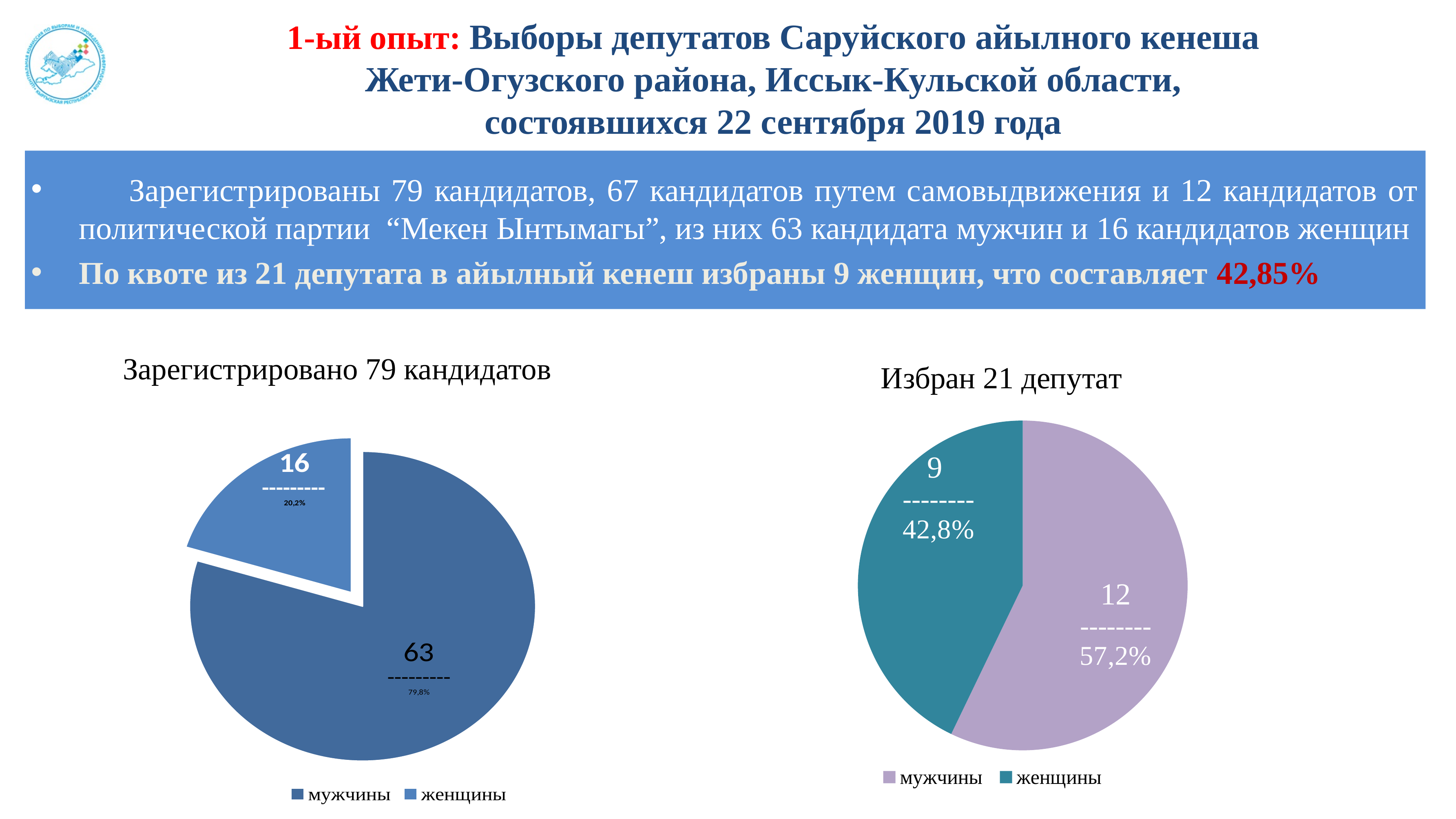
What kind of chart is the left chart 'Зарегистрировано 79 кандидатов'? pie chart In the right chart 'Избран 21 депутат', which category is the largest? мужчины In the left chart 'Зарегистрировано 79 кандидатов', what is the value for женщины? 16 In the left chart 'Зарегистрировано 79 кандидатов', what is the difference between мужчины and женщины? 47 In the right chart 'Избран 21 депутат', what share of the pie is женщины? 42,8% In the left chart 'Зарегистрировано 79 кандидатов', what is the value for мужчины? 63 In the left chart 'Зарегистрировано 79 кандидатов', what share of the pie is мужчины? 79,8% In the right chart 'Избран 21 депутат', what is the value for мужчины? 12 In the right chart 'Избран 21 депутат', what is the value for женщины? 9 How many entries does the legend of the right chart 'Избран 21 депутат' list? 2 In the right chart 'Избран 21 депутат', what is the difference between мужчины and женщины? 3 In the left chart 'Зарегистрировано 79 кандидатов', what share of the pie is женщины? 20,2%